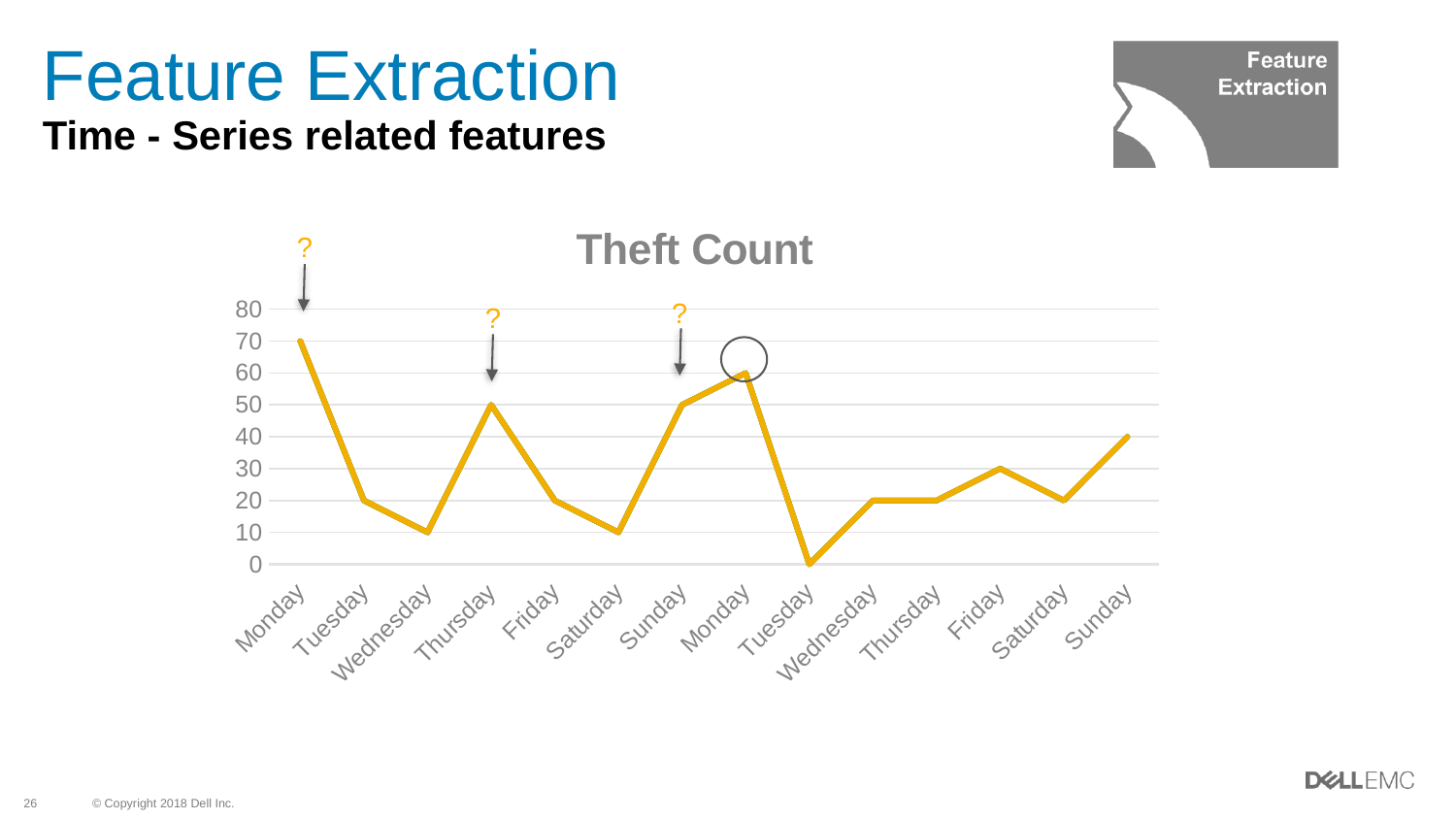
What is the theft count for the last Sunday on the x axis? 40 What is the theft count for the second Tuesday on the x axis? 0 What is the difference between the theft count on the first Monday and the second Monday? 10 Which is larger, the theft count on the first Thursday or the second Thursday? the first Thursday Does the theft count rise or fall from the second Wednesday to the last Sunday? rise What is the theft count for the second Monday on the x axis? 60 What is the title of the chart? Theft Count Which day has the highest theft count? the first Monday What is the theft count for the first Monday on the x axis? 70 Which day has the lowest theft count? the second Tuesday How many data points are plotted on the Theft Count line? 14 What kind of chart is shown on the slide? line chart